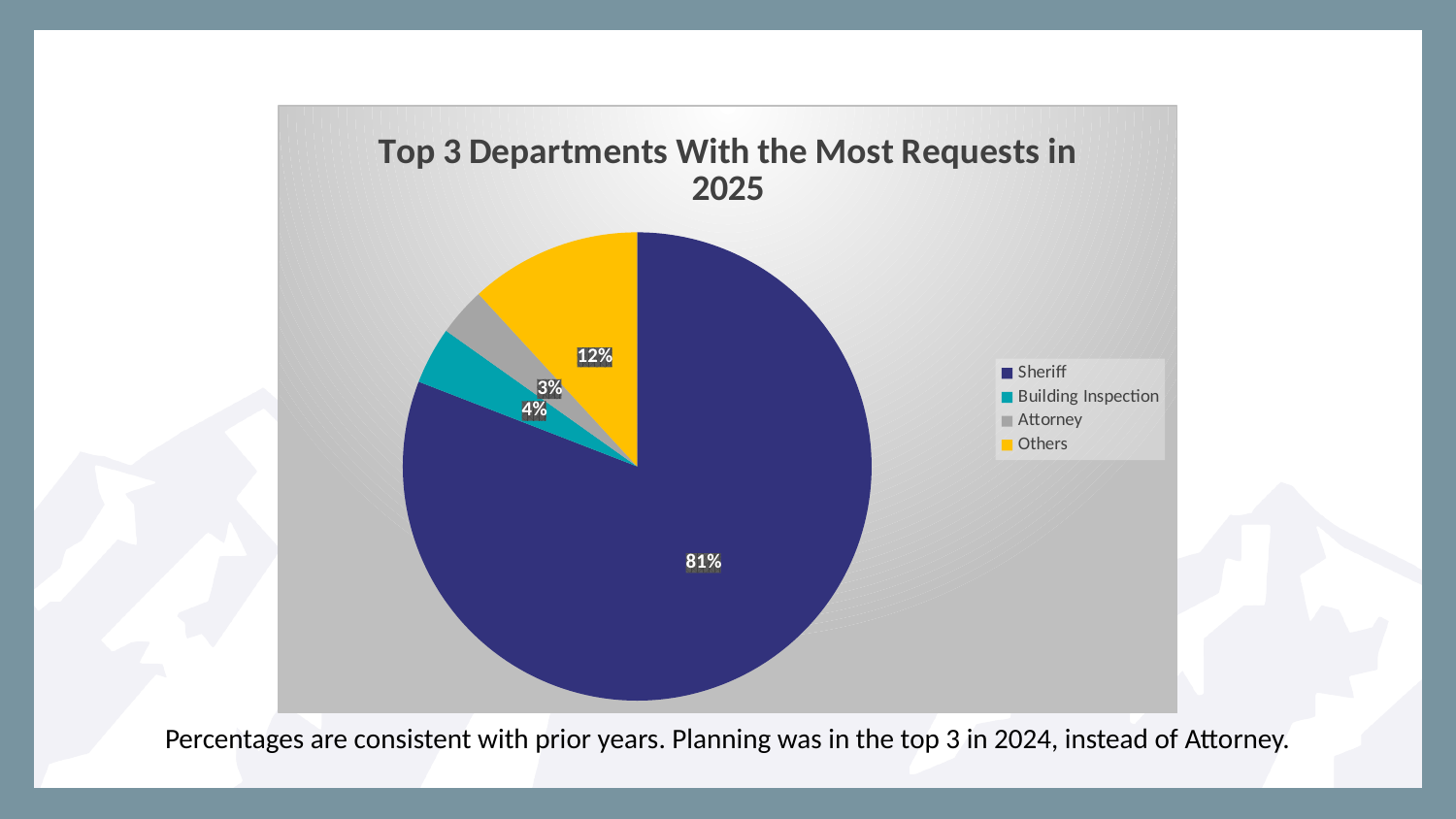
How many entries are listed in the legend? 4 What is the difference in percentage points between the Sheriff slice and the Others slice? 69 What percentage is shown for Attorney? 3% What percentage of requests does the Sheriff slice represent? 81% How many slices does the pie chart have? 4 What is the title of the chart? Top 3 Departments With the Most Requests in 2025 Which is larger, the Building Inspection slice or the Others slice? Others What type of chart is shown on the slide? Pie chart Which category has the largest share of the pie? Sheriff What percentage is shown for Building Inspection? 4% Which category has the smallest share of the pie? Attorney What percentage is shown for Others? 12%